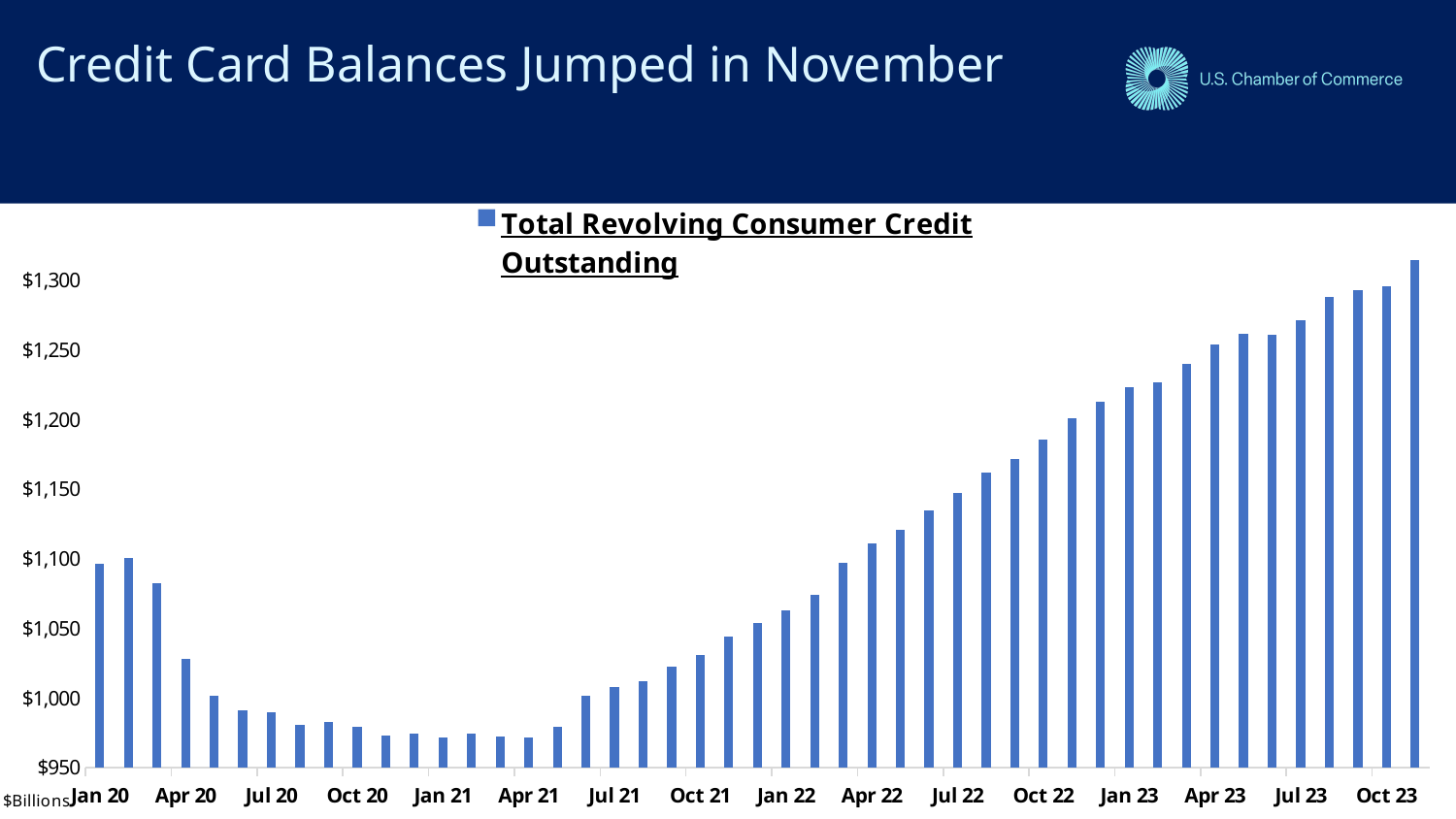
Is the value for Jul 23 greater or less than $1,250? greater Is the value for Jan 21 greater or less than $1,000? less What kind of chart is shown on the slide? bar chart How many series does the legend list? 1 Which bar is the highest in the chart? the last (rightmost) bar, just after Oct 23 From Apr 21 to Oct 23, do the values rise or fall along the x axis? rise Is the value for Jan 23 greater or less than $1,200? greater Which is larger, the value for Jan 20 or the value for Jan 21? Jan 20 What is the name of the series shown in the legend? Total Revolving Consumer Credit Outstanding What unit is indicated for the values on the vertical axis? $Billions